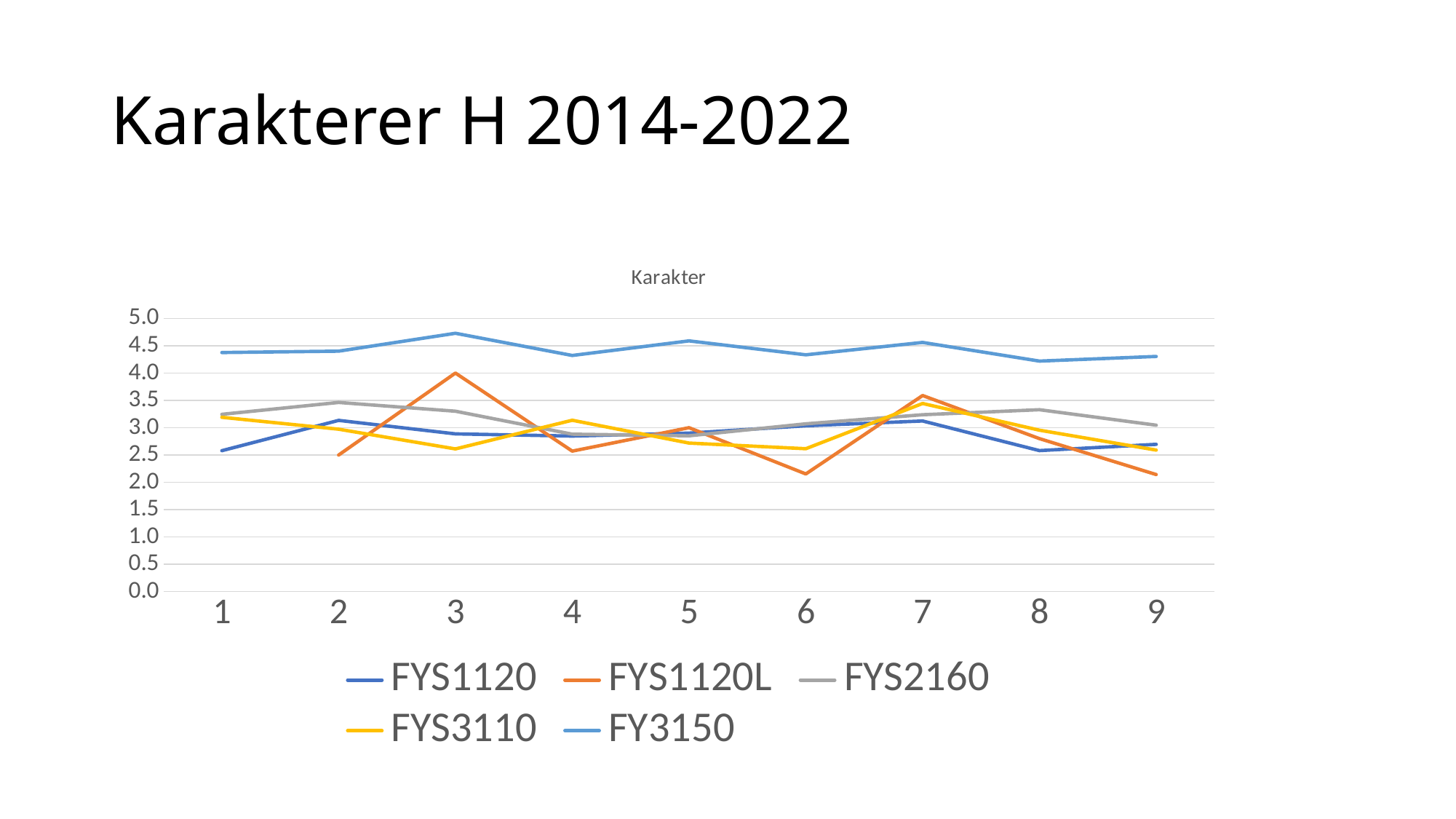
What kind of chart is shown on the slide? line chart Which series has the lowest value at point 6? FYS1120L Is the value for FYS1120L at point 6 greater or less than 2.5? less How many series does the legend list? 5 At point 9, which is larger: FYS1120L or FYS2160? FYS2160 Is the value for FYS2160 at point 2 greater or less than 3.0? greater Is the value for FY3150 at point 3 greater or less than 4.5? greater Which series has the highest value at point 3? FY3150 Does the FYS1120L line rise or fall from point 7 to point 9? fall How many points are there along the x axis? 9 What is the title printed above the chart? Karakter